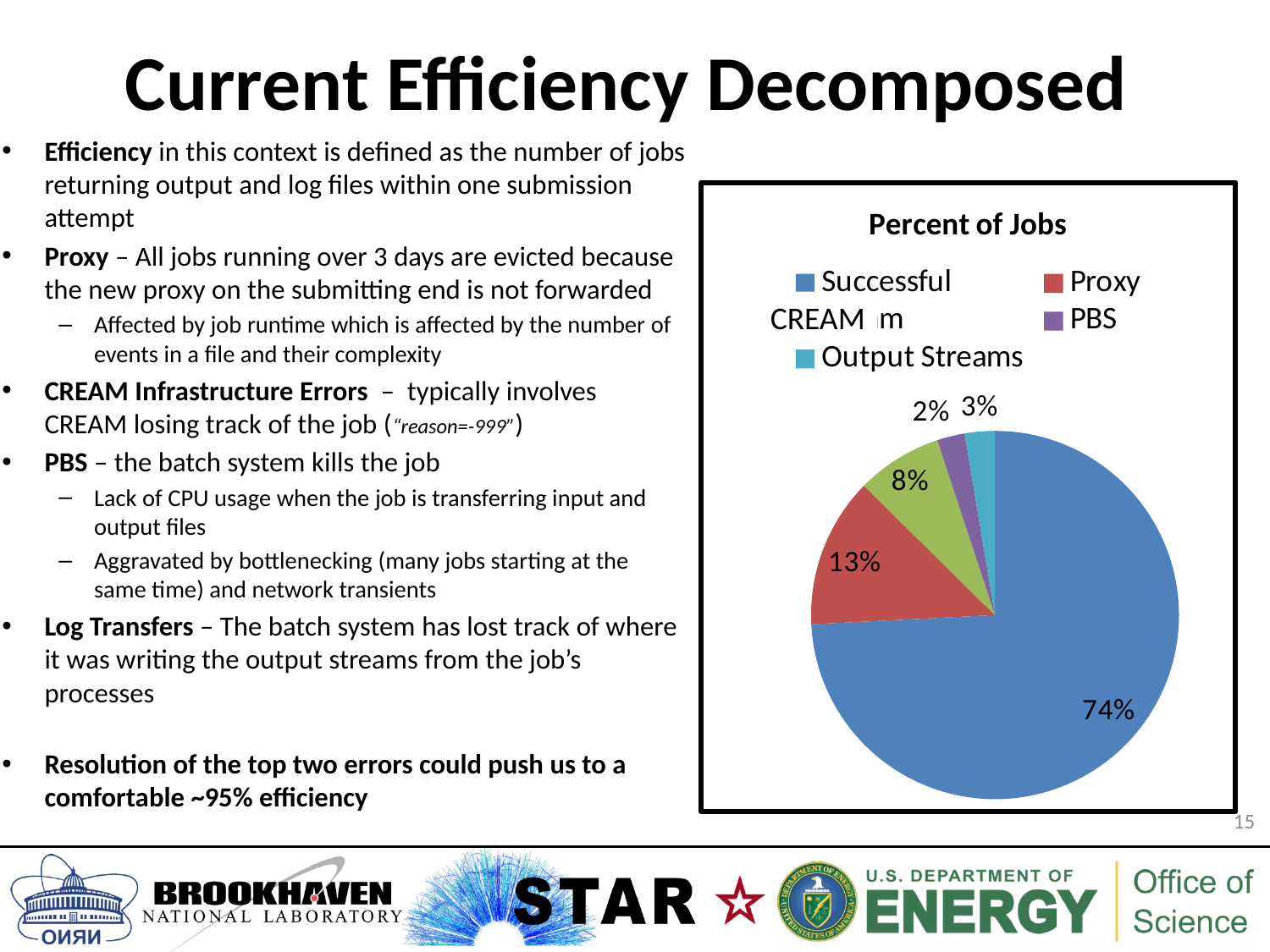
What colour is the Successful slice? blue What percentage of jobs is attributed to Proxy? 13% What percentage of jobs is shown as Successful? 74% How many categories does the legend list? 5 What is the title of the chart? Percent of Jobs Which is larger, the Proxy share or the Output Streams share? Proxy What percentage of jobs is attributed to Output Streams? 3% What is the difference between the Successful share and the Proxy share? 61% What percentage of jobs is attributed to PBS? 2% Which category has the largest share of the pie? Successful Which category has the smallest share of the pie? PBS What kind of chart is shown on the slide? pie chart